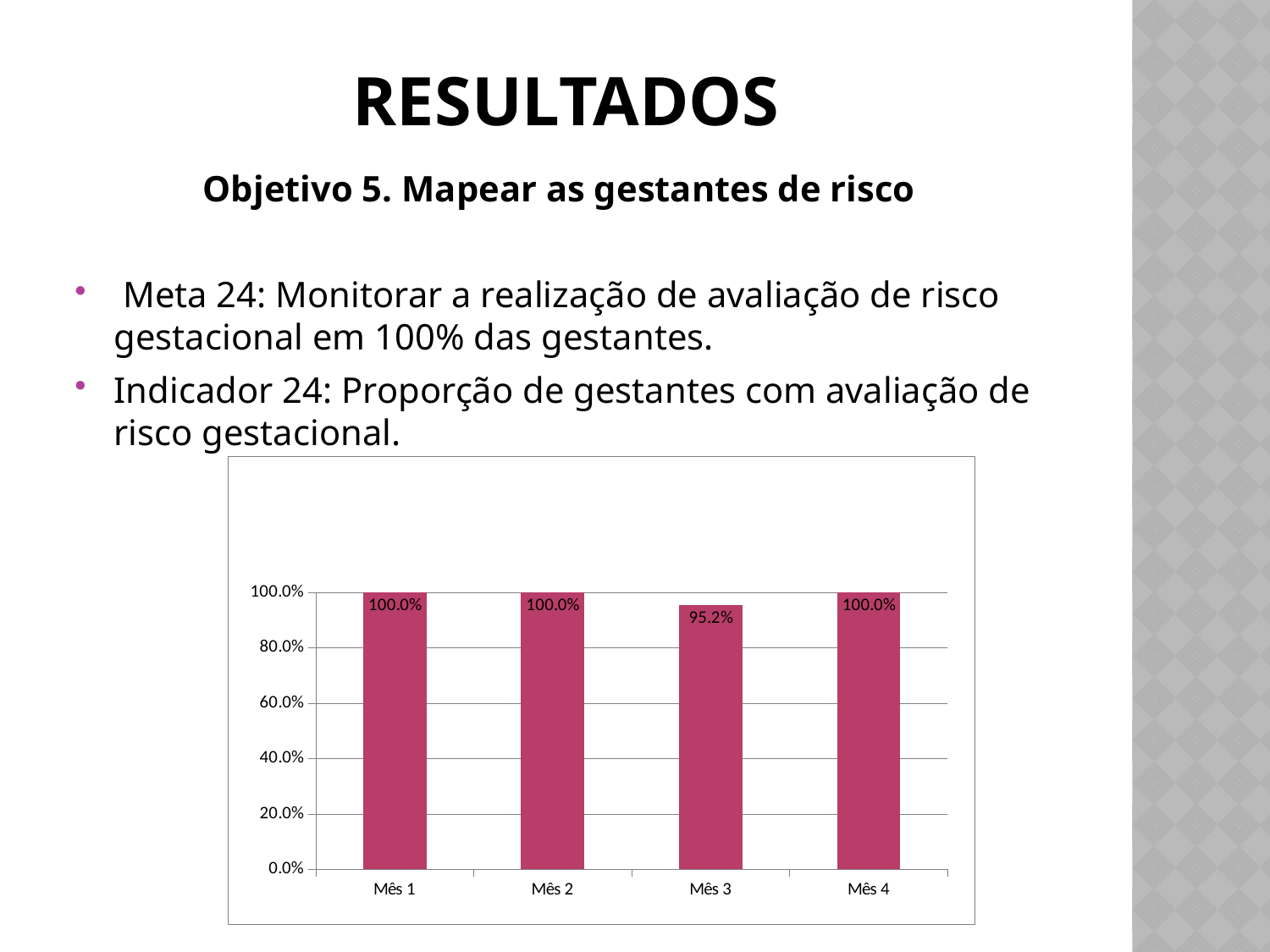
What is the value for Mês 1? 100.0% How many bars reach 100.0%? 3 What is the difference between the values for Mês 2 and Mês 3? 4.8% Is the value for Mês 3 greater or less than 80.0%? greater What is the value for Mês 3? 95.2% Which month has the lowest value? Mês 3 Which is larger, the value for Mês 3 or the value for Mês 4? Mês 4 What colour are the bars in the chart? magenta/pink How many months are shown on the x axis? 4 What kind of chart is shown on the slide? bar chart What is the value for Mês 4? 100.0% What is the highest tick value shown on the y axis? 100.0%